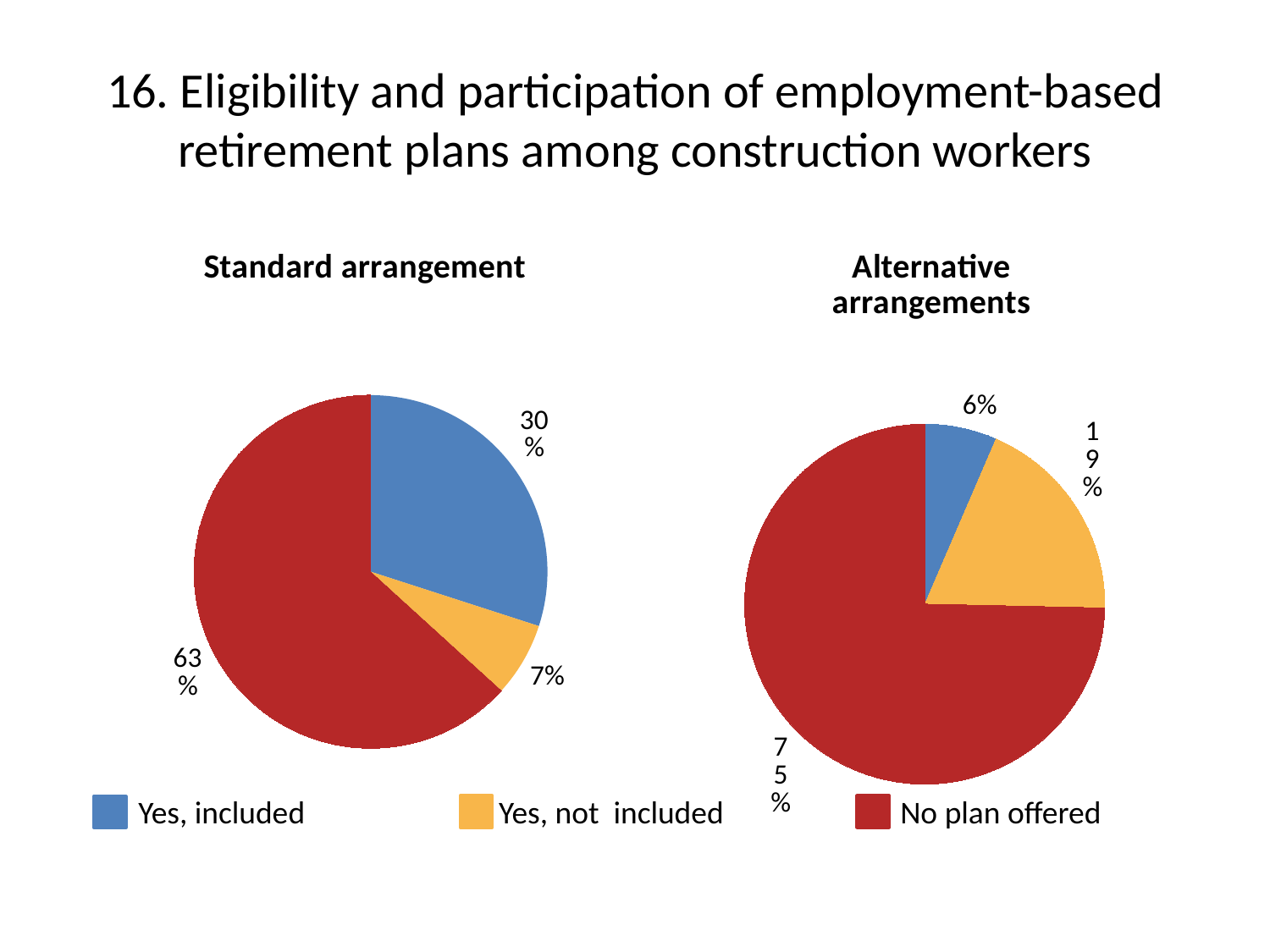
What is the difference between the 'No plan offered' share in the Alternative arrangements chart and the 'No plan offered' share in the Standard arrangement chart? 12% In the Standard arrangement chart, what share is labelled for the 'Yes, included' slice? 30% In the Standard arrangement chart, what share is labelled for the 'No plan offered' slice? 63% How many slices does the Standard arrangement pie chart have? 3 Which is larger: the 'Yes, included' share in the Standard arrangement chart or the 'Yes, included' share in the Alternative arrangements chart? Standard arrangement What colour represents 'No plan offered' in the legend? Red In the Alternative arrangements chart, what share is labelled for the 'No plan offered' slice? 75% What type of chart is used for the Alternative arrangements data? Pie chart In the Standard arrangement chart, which category has the largest slice? No plan offered In the Alternative arrangements chart, what share is labelled for the 'Yes, not included' slice? 19% In the Alternative arrangements chart, which category has the smallest slice? Yes, included In the Alternative arrangements chart, what share is labelled for the 'Yes, included' slice? 6%